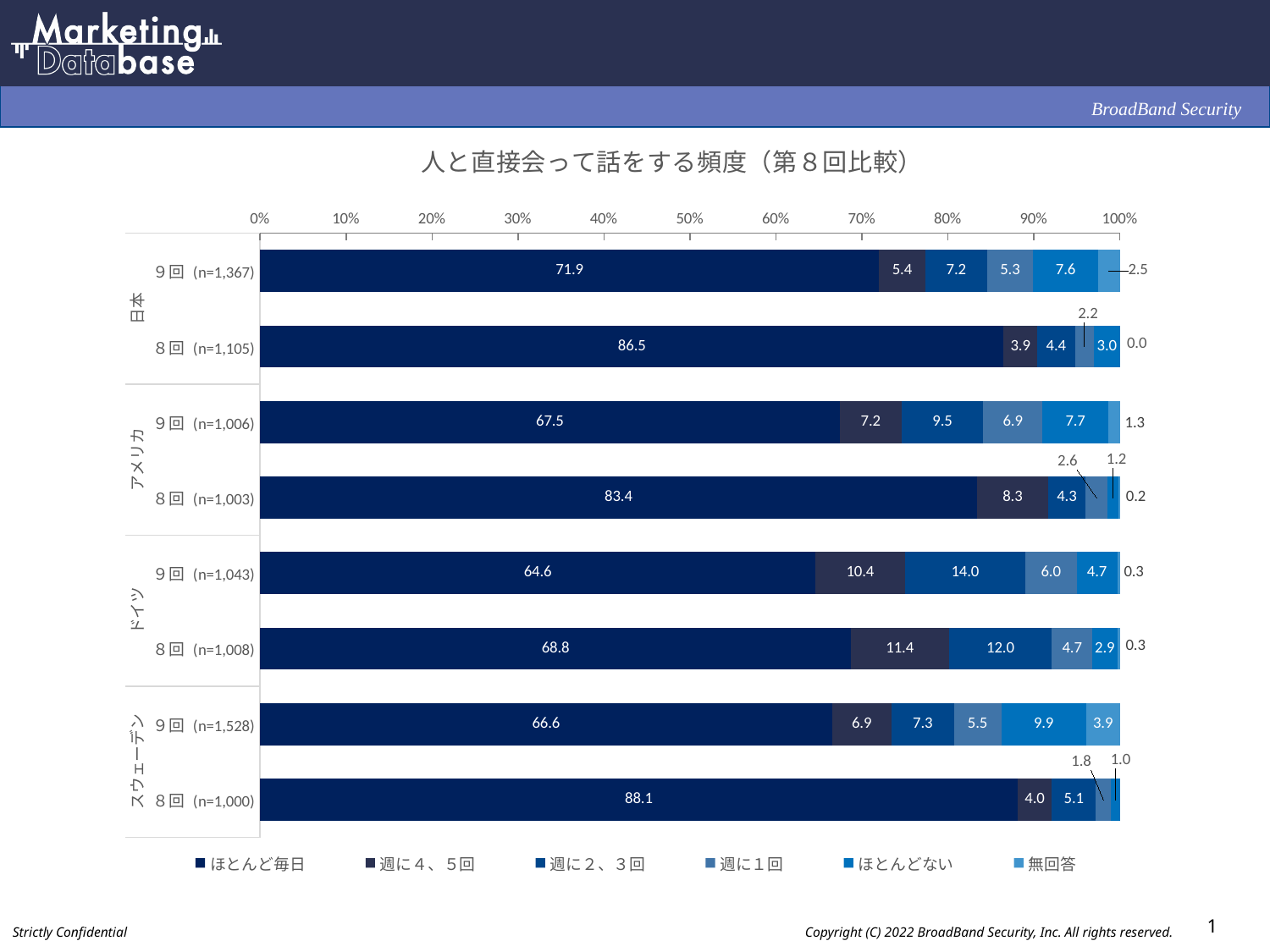
Which bar has the lowest value for ほとんど毎日? ドイツ 9回 (n=1,043) What is the value of 週に４、５回 for アメリカ 8回 (n=1,003)? 8.3 How many series does the legend list? 6 Which is larger, the 週に１回 value for ドイツ 9回 (n=1,043) or for ドイツ 8回 (n=1,008)? ドイツ 9回 (n=1,043) What type of chart is shown on the slide? Stacked bar chart Which bar has the highest value for ほとんど毎日? スウェーデン 8回 (n=1,000) What is the title of the chart? 人と直接会って話をする頻度（第８回比較） What is the difference in ほとんど毎日 between 日本 8回 (n=1,105) and 日本 9回 (n=1,367)? 14.6 What is the value of ほとんどない for スウェーデン 9回 (n=1,528)? 9.9 What is the value of ほとんど毎日 for 日本 9回 (n=1,367)? 71.9 What is the value of 週に２、３回 for ドイツ 9回 (n=1,043)? 14.0 How many bars are plotted in the chart? 8